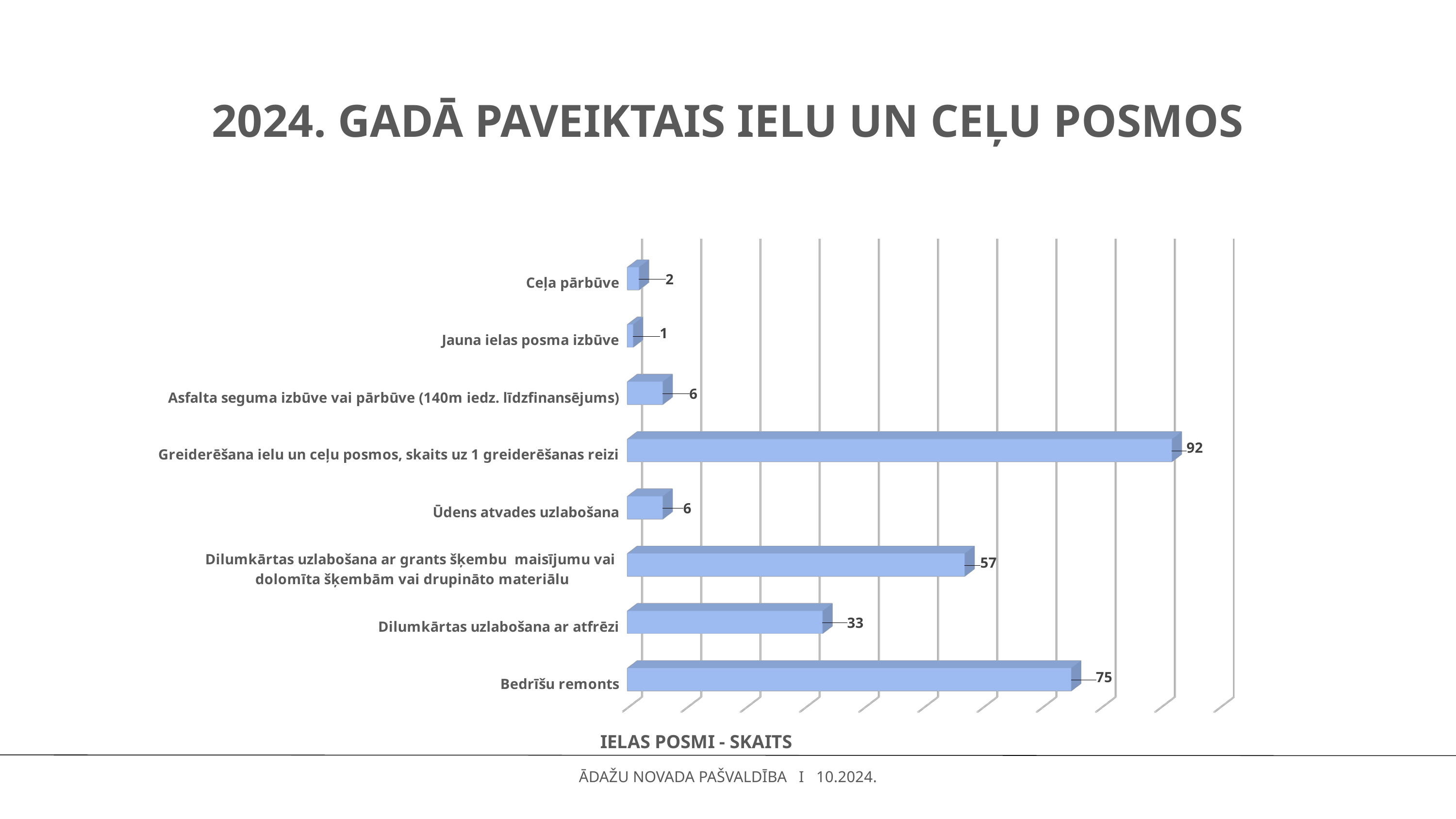
What is the value for Ūdens atvades uzlabošana? 6 What kind of chart is shown on the slide? Bar chart Which category has the lowest value? Jauna ielas posma izbūve Which is larger: the value for Dilumkārtas uzlabošana ar grants šķembu maisījumu vai dolomīta šķembām vai drupināto materiālu or the value for Bedrīšu remonts? Bedrīšu remonts Which category has the highest value? Greiderēšana ielu un ceļu posmos, skaits uz 1 greiderēšanas reizi What is the difference between the values for Greiderēšana ielu un ceļu posmos, skaits uz 1 greiderēšanas reizi and Bedrīšu remonts? 17 How many categories are shown in the chart? 8 What is the value for Jauna ielas posma izbūve? 1 What is the difference between the values for Bedrīšu remonts and Dilumkārtas uzlabošana ar atfrēzi? 42 What is the axis title shown below the chart? IELAS POSMI - SKAITS What is the value for Bedrīšu remonts? 75 What is the value for Dilumkārtas uzlabošana ar atfrēzi? 33